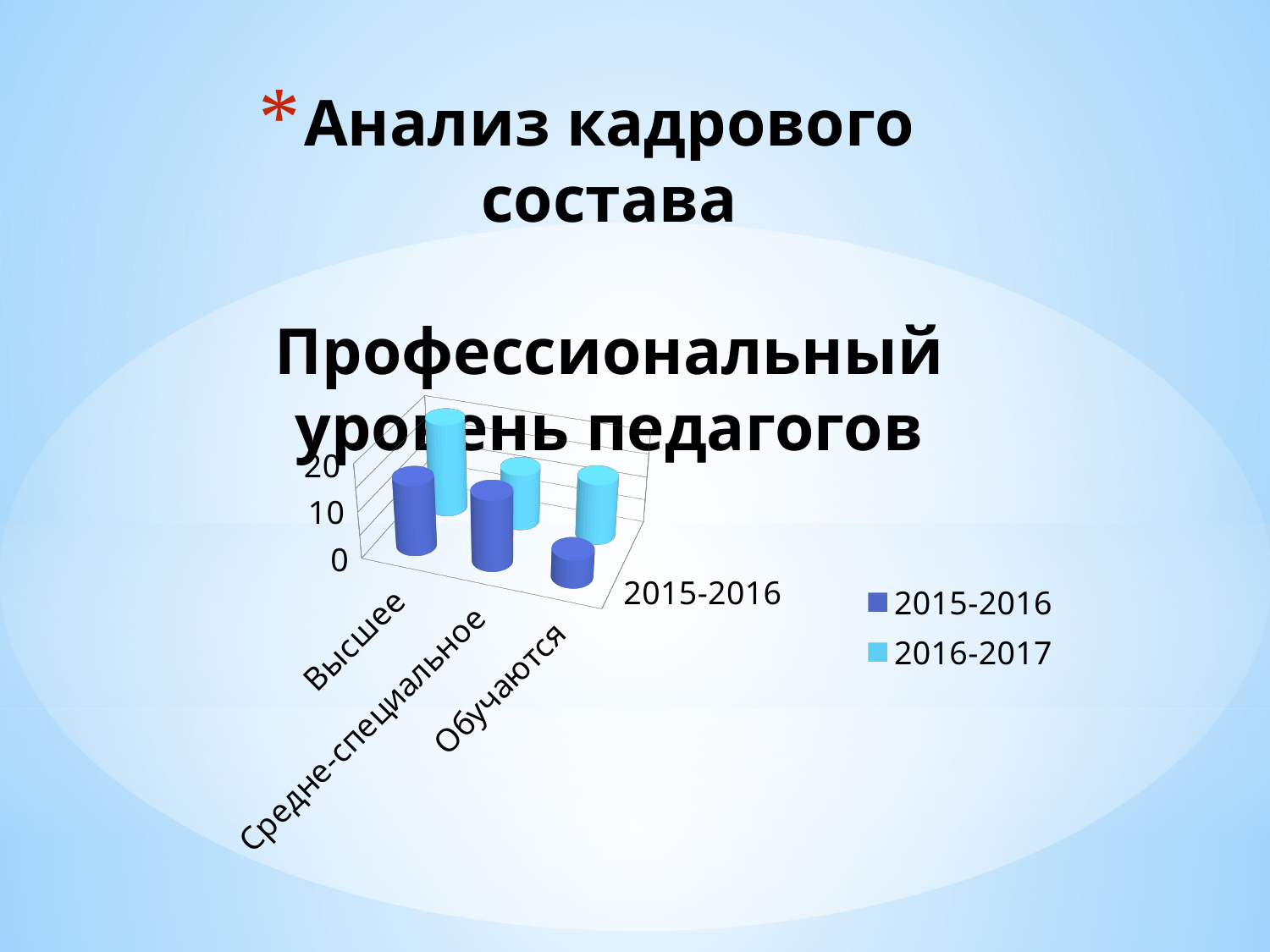
How many series does the legend list? 2 In the 2015-2016 series, which is larger: Высшее or Обучаются? Высшее In the 2015-2016 series, which is larger: Средне-специальное or Обучаются? Средне-специальное In the 2016-2017 series, which is larger: Высшее or Обучаются? Высшее How many categories are shown on the category axis? 3 What kind of chart is shown on the slide? bar chart Which series are listed in the legend? 2015-2016, 2016-2017 Which category has the lowest value for the 2015-2016 series? Обучаются Which category has the highest value for the 2016-2017 series? Высшее What is the title of the chart? Профессиональный уровень педагогов Is the value for Обучаются in the 2015-2016 series greater or less than 10? less